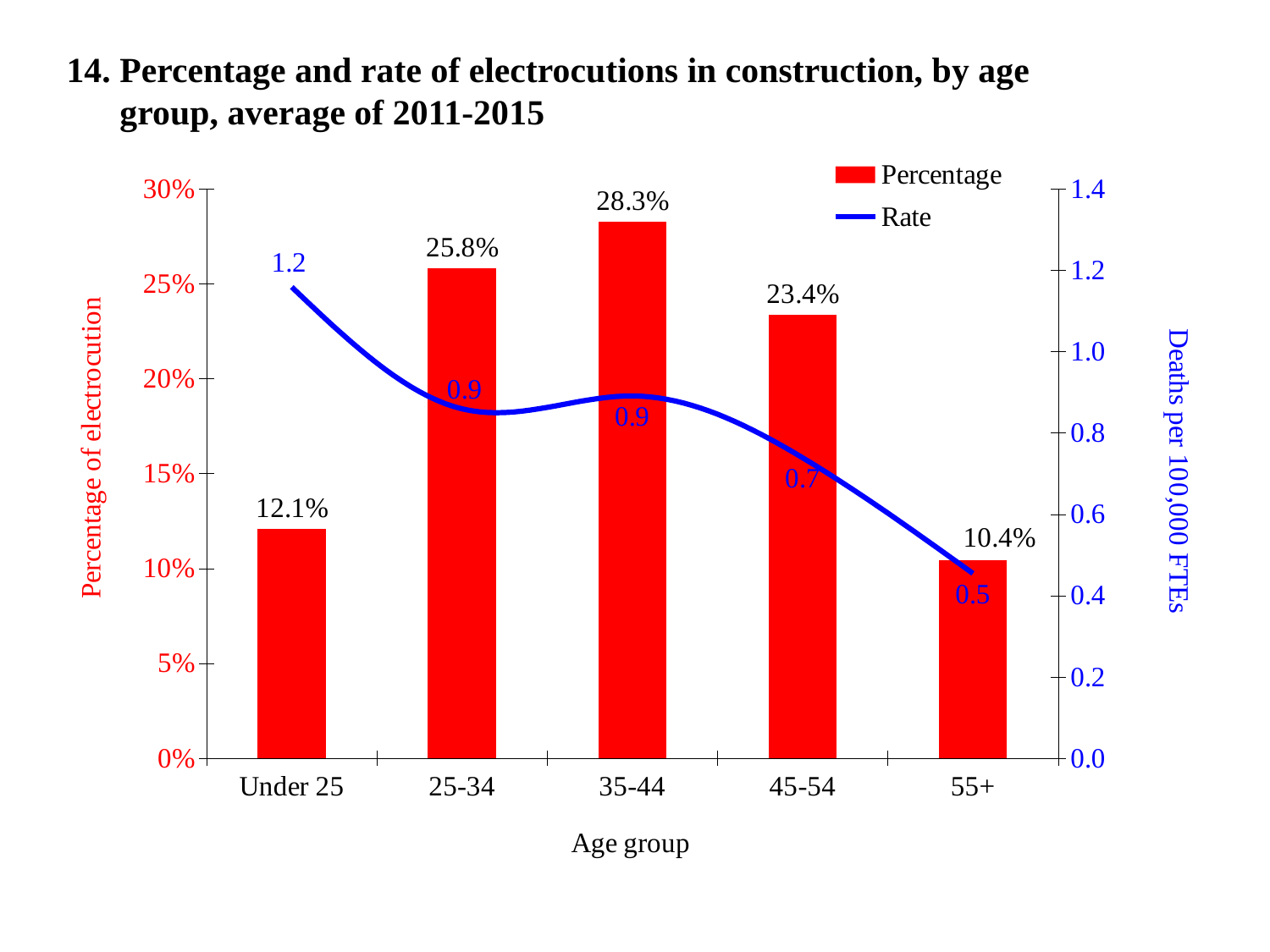
Which age group has the lowest rate of electrocutions? 55+ Which age group has the highest percentage of electrocutions? 35-44 What is the rate of electrocutions for the 45-54 age group? 0.7 What is the difference in percentage of electrocutions between the 35-44 and Under 25 age groups? 16.2% Does the rate of electrocutions generally rise or fall from the Under 25 group to the 55+ group? fall What is the percentage of electrocutions for the 55+ age group? 10.4% What is the rate of electrocutions (deaths per 100,000 FTEs) for the Under 25 age group? 1.2 What is the label of the right-hand vertical axis? Deaths per 100,000 FTEs How many age groups are shown on the x axis? 5 What is the percentage of electrocutions for the 35-44 age group? 28.3% How many series does the legend list? 2 Which age group has a higher percentage of electrocutions, 25-34 or 45-54? 25-34